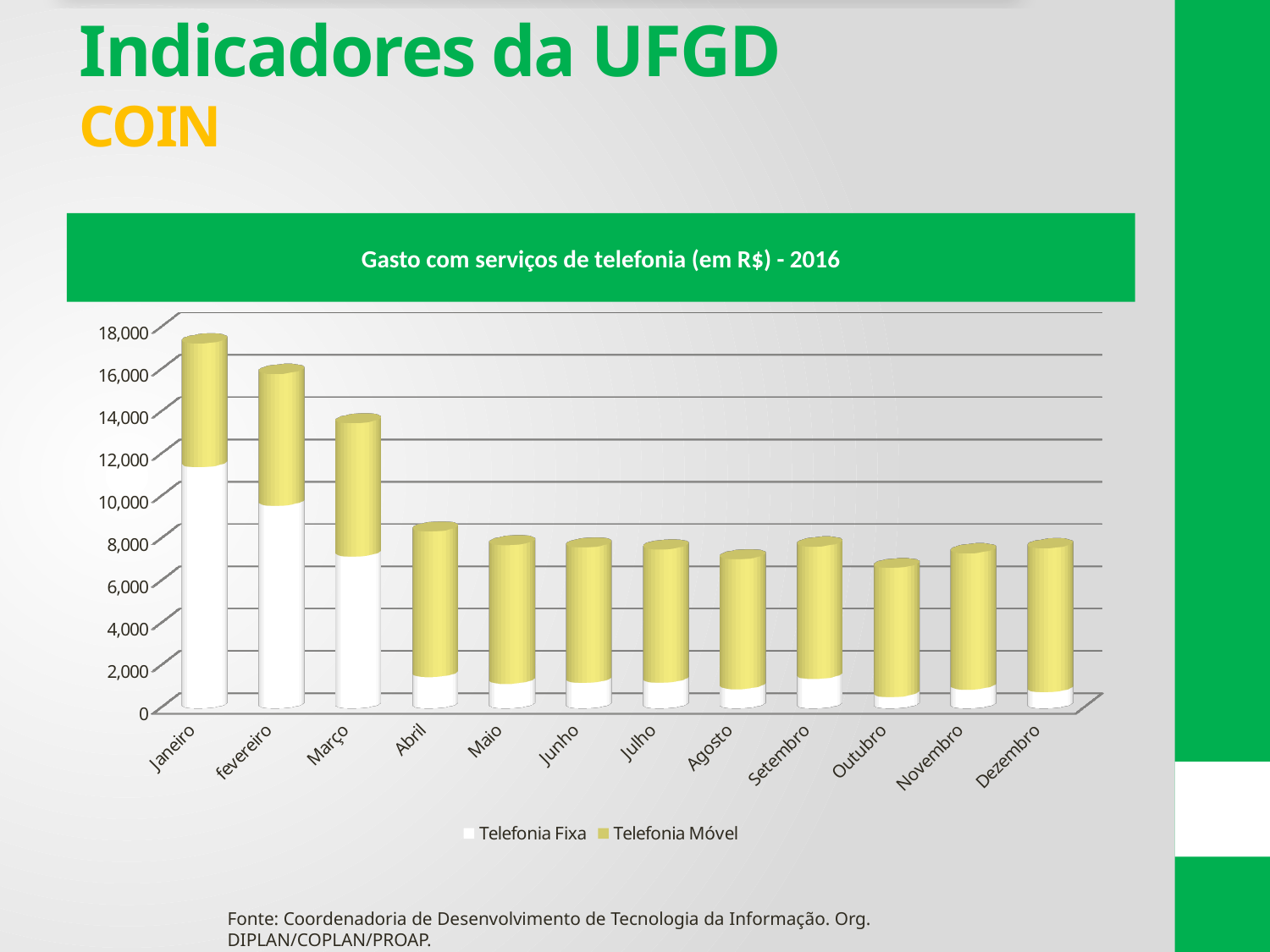
Which two series are listed in the chart legend? Telefonia Fixa and Telefonia Móvel Which month has a larger total spending, Janeiro or Março? Janeiro Which month has the highest total telephony spending? Janeiro How many series does the chart legend list? 2 Is the total value for Março greater or less than 12,000? greater Which month has the lowest total telephony spending? Outubro How many months are shown on the x axis of the chart? 12 Is the total value for Janeiro greater or less than 16,000? greater Is the total value for Outubro greater or less than 8,000? less Do the total values rise or fall from Janeiro to Abril? fall What is the title of the chart? Gasto com serviços de telefonia (em R$) - 2016 What type of chart is shown on the slide? stacked bar chart